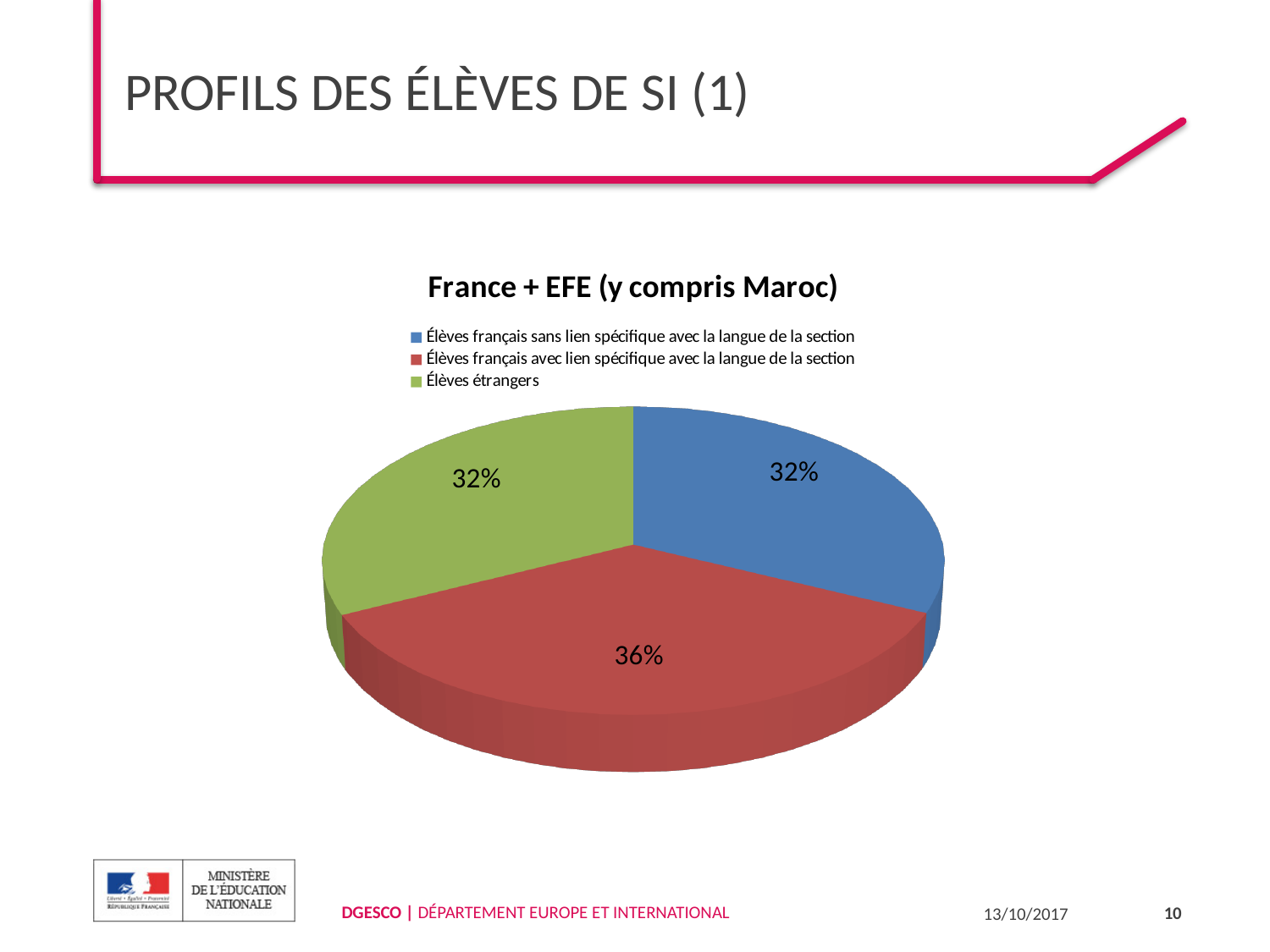
What kind of chart is shown on the slide? Pie chart What share of the pie is 'Élèves français sans lien spécifique avec la langue de la section'? 32% What colour is the slice for 'Élèves étrangers'? Green What is the difference in percentage points between 'Élèves français avec lien spécifique avec la langue de la section' and 'Élèves étrangers'? 4 percentage points What share of the pie is 'Élèves français avec lien spécifique avec la langue de la section'? 36% What share of the pie is 'Élèves étrangers'? 32% Which is larger: the share for 'Élèves français avec lien spécifique avec la langue de la section' or the share for 'Élèves étrangers'? Élèves français avec lien spécifique avec la langue de la section How many slices does the pie chart have? 3 Is the share for 'Élèves français avec lien spécifique avec la langue de la section' greater or less than 50%? less What is the title of the chart? France + EFE (y compris Maroc) Which category has the largest share of the pie? Élèves français avec lien spécifique avec la langue de la section How many entries does the legend list? 3